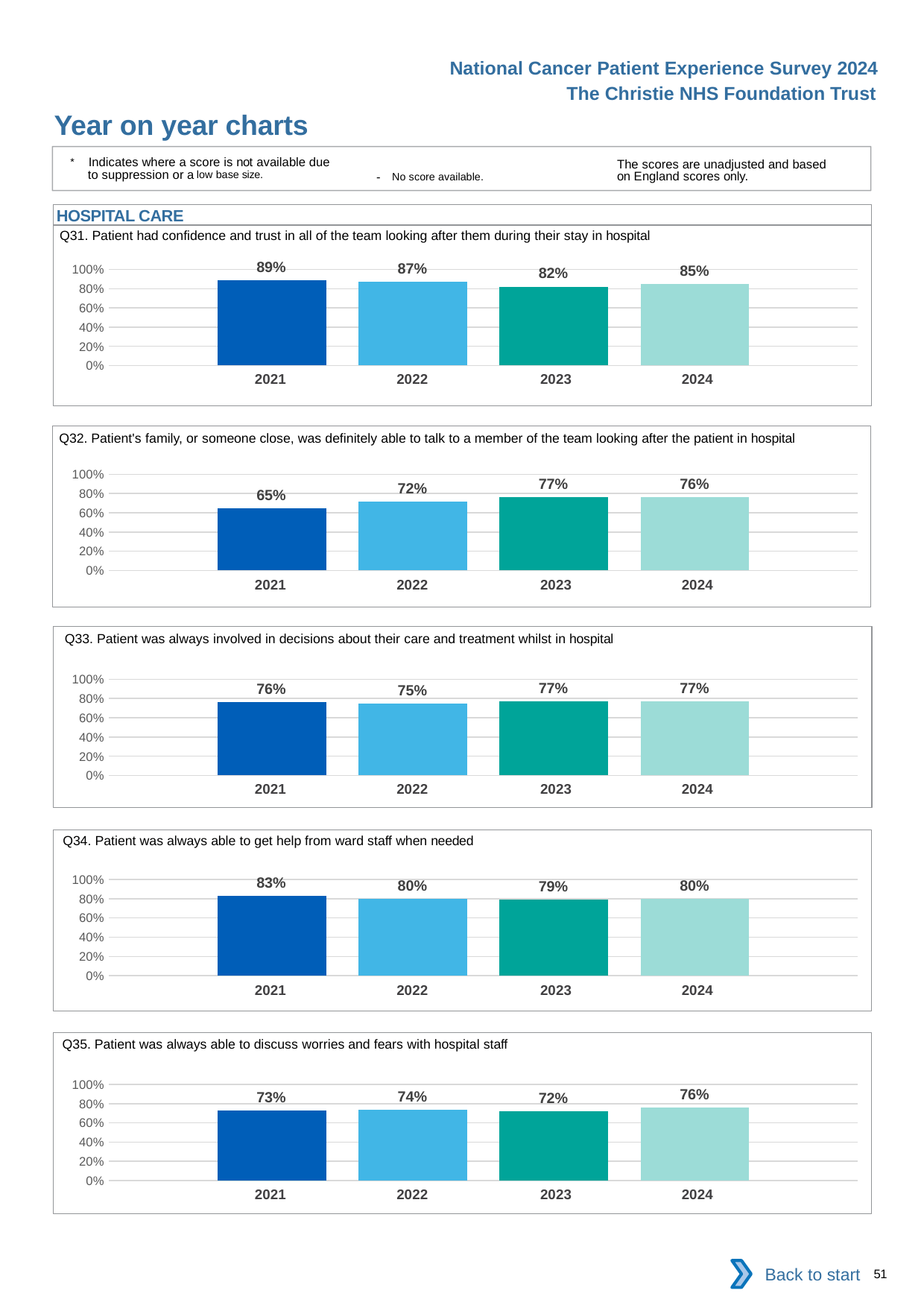
In the Q31 chart, what is the value for 2021? 89% In the Q35 chart, which is larger, the value for 2022 or the value for 2023? 2022 How many years are shown on the x axis of the Q33 chart? 4 In the Q32 chart, which year has the highest value? 2023 In the Q32 chart, what is the difference between the 2023 and 2021 values? 12% In the Q31 chart, which year has the lowest value? 2023 In the Q35 chart, what is the value for 2024? 76% In the Q34 chart, what is the difference between the 2021 and 2023 values? 4% In the Q34 chart, which year has the highest value? 2021 In the Q32 chart, what is the value for 2024? 76% What type of chart is the Q31 chart? Bar chart In the Q33 chart, what is the value for 2022? 75%